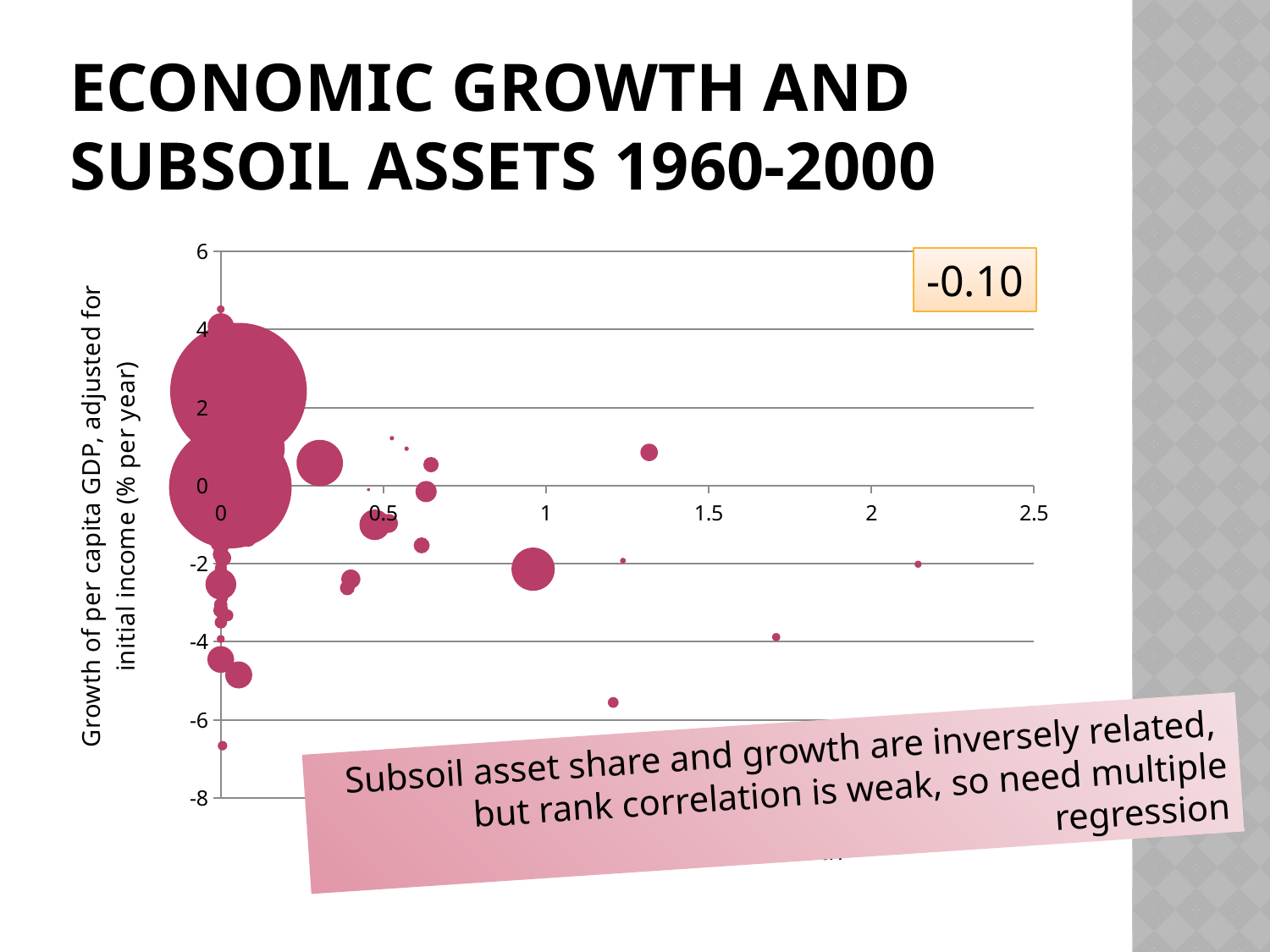
According to the slide, do growth values tend to rise or fall as subsoil asset share increases along the x axis? fall Is the growth value of the bubble located near 0.3 on the horizontal axis greater or less than 0? greater Is the growth value of the bubble located near 1.3 on the horizontal axis greater or less than 0? greater What is the lowest tick value shown on the vertical axis? -8 What is the title of the vertical axis of the chart? Growth of per capita GDP, adjusted for initial income (% per year) Is the growth value of the point located near 1.7 on the horizontal axis greater or less than -2? less What kind of chart is shown on the slide? bubble chart What is the highest tick value shown on the horizontal axis? 2.5 What value is shown in the highlighted box at the top right of the chart? -0.10 What is the highest tick value shown on the vertical axis? 6